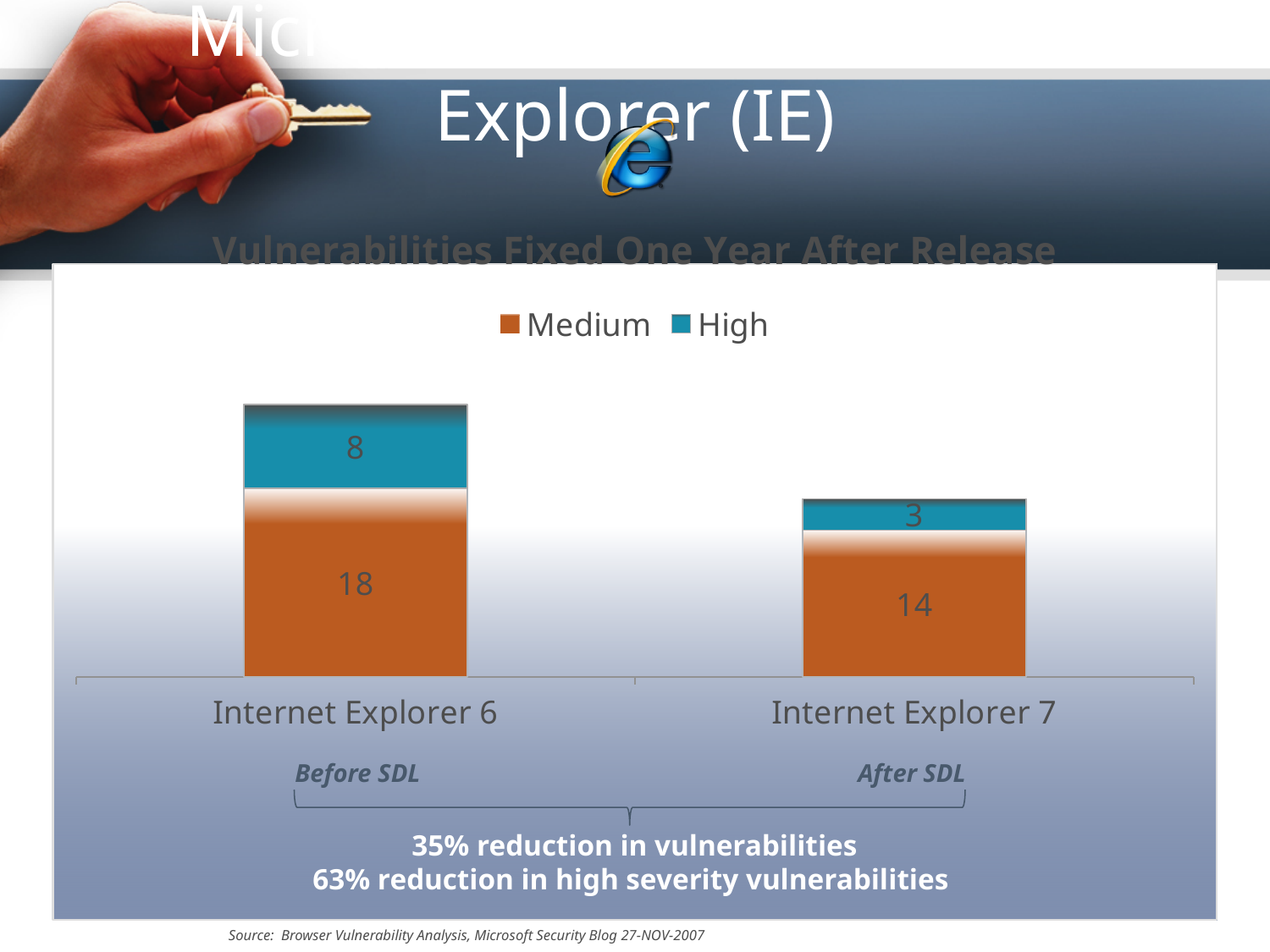
How many series does the legend list? 2 What kind of chart is shown on the slide? Stacked bar chart Which series is shown in orange in the legend? Medium Which category has the higher Medium value, Internet Explorer 6 or Internet Explorer 7? Internet Explorer 6 What is the difference between the High values for Internet Explorer 6 and Internet Explorer 7? 5 What is the High value for Internet Explorer 7? 3 What is the total of the stacked bar for Internet Explorer 7? 17 What is the Medium value for Internet Explorer 6? 18 What is the Medium value for Internet Explorer 7? 14 What is the High value for Internet Explorer 6? 8 How many categories are shown on the x axis? 2 What is the total of the stacked bar for Internet Explorer 6? 26